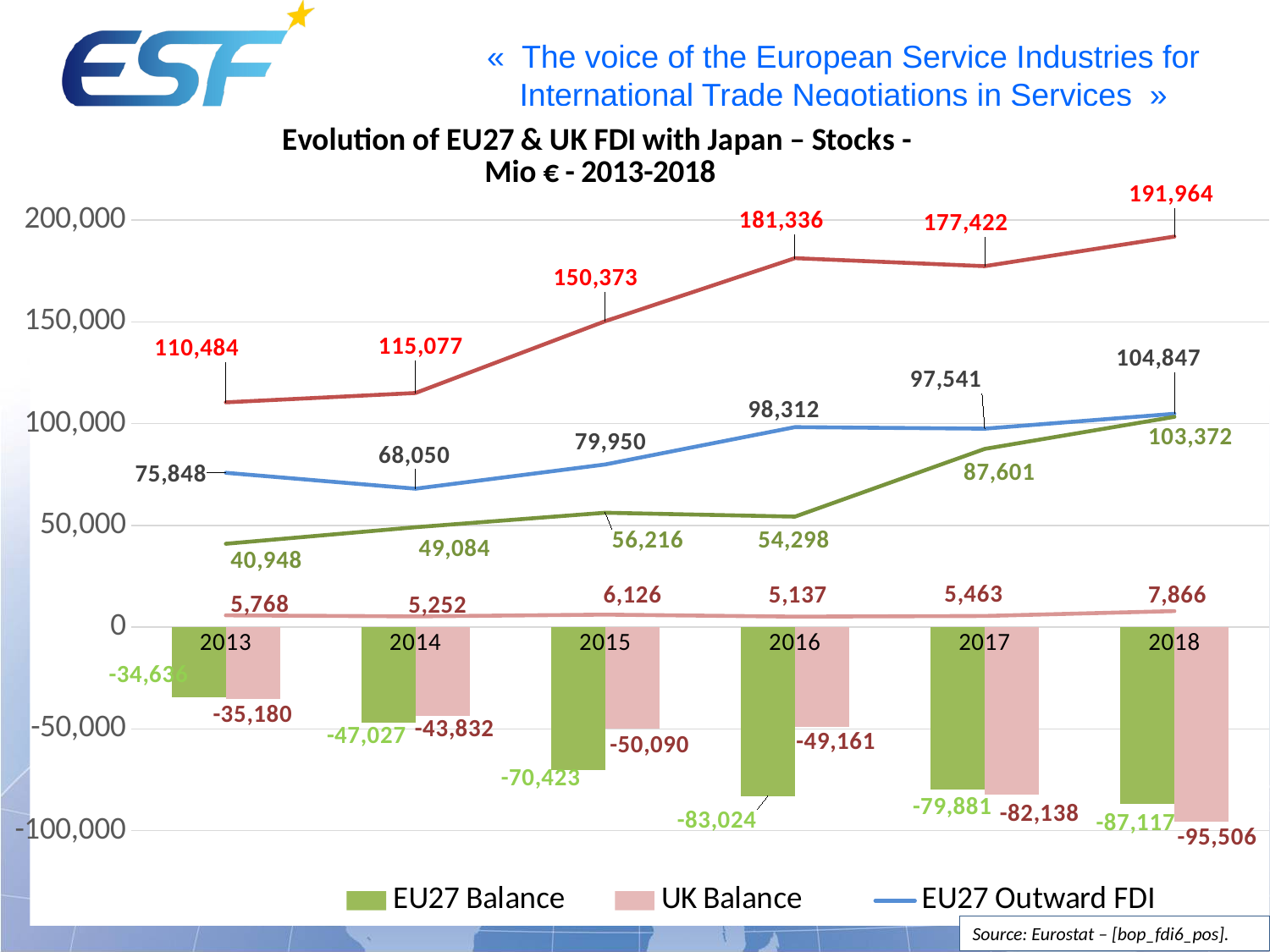
In which year is EU27 Outward FDI highest? 2018 What is the UK Balance value for 2018? -95,506 By how much did EU27 Outward FDI increase from 2013 to 2018? 28,999 In 2015, which is lower, the EU27 Balance or the UK Balance? EU27 Balance What is the EU27 Outward FDI value for 2014? 68,050 What is the EU27 Outward FDI value for 2016? 98,312 Does EU27 Outward FDI rise or fall from 2014 to 2016? Rise How many years are shown on the x axis? 6 In which year is EU27 Outward FDI lowest? 2014 What is the title of the chart? Evolution of EU27 & UK FDI with Japan – Stocks - Mio € - 2013-2018 What kind of chart is this? Combined bar and line chart What is the EU27 Balance value for 2015? -70,423